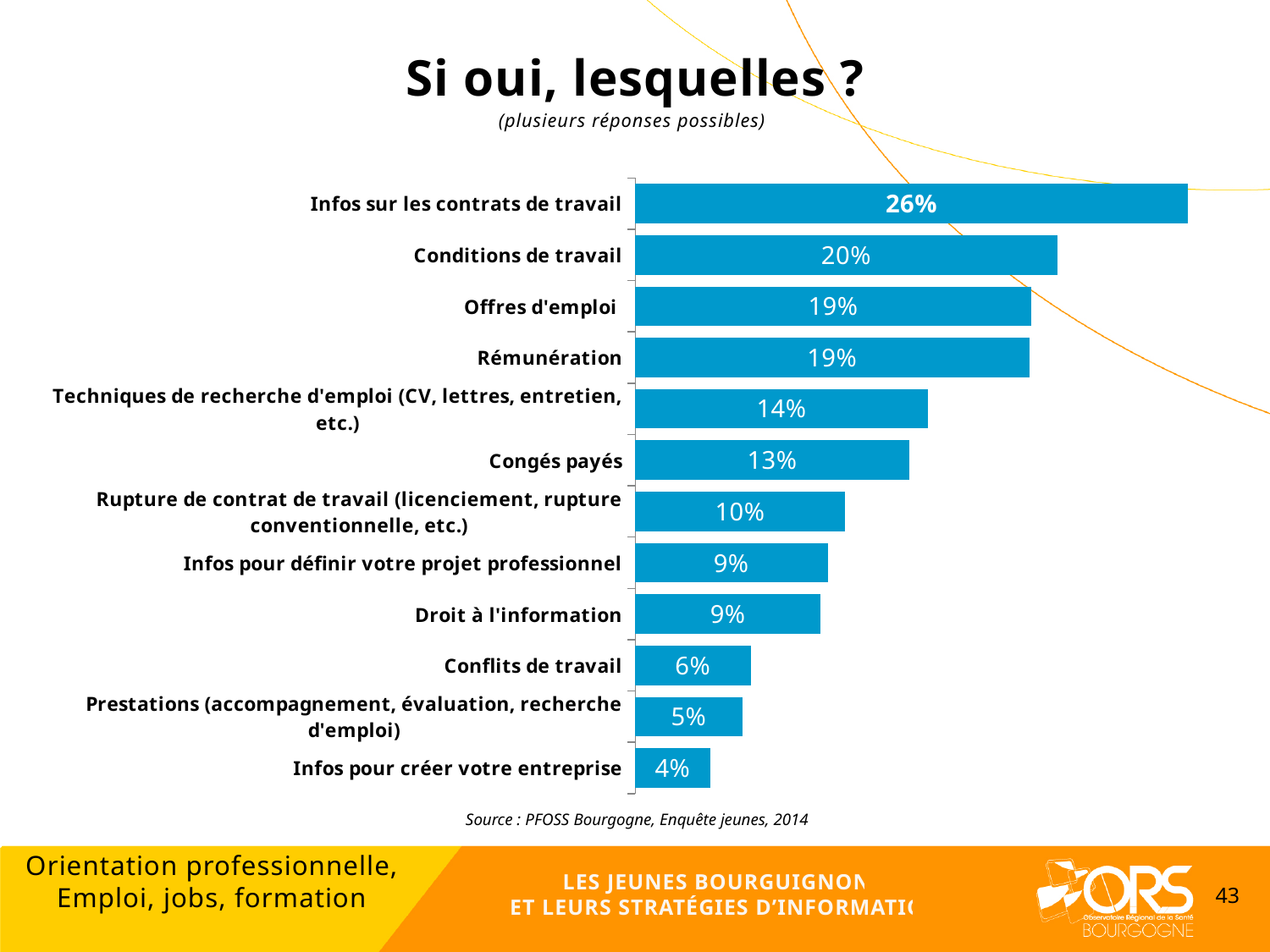
Which is larger, the value for "Techniques de recherche d'emploi (CV, lettres, entretien, etc.)" or the value for "Rupture de contrat de travail (licenciement, rupture conventionnelle, etc.)"? Techniques de recherche d'emploi (CV, lettres, entretien, etc.) Which category has the lowest value? Infos pour créer votre entreprise What is the difference between the values for "Infos sur les contrats de travail" and "Infos pour créer votre entreprise"? 22% What is the difference between the values for "Conditions de travail" and "Congés payés"? 7% Which category has the highest value? Infos sur les contrats de travail How many categories are shown in the chart? 12 What is the value for "Congés payés"? 13% What is the value for "Conflits de travail"? 6% What is the value for "Prestations (accompagnement, évaluation, recherche d'emploi)"? 5% What is the value for "Infos sur les contrats de travail"? 26% What kind of chart is shown on the slide? Bar chart What is the title of the chart? Si oui, lesquelles ?